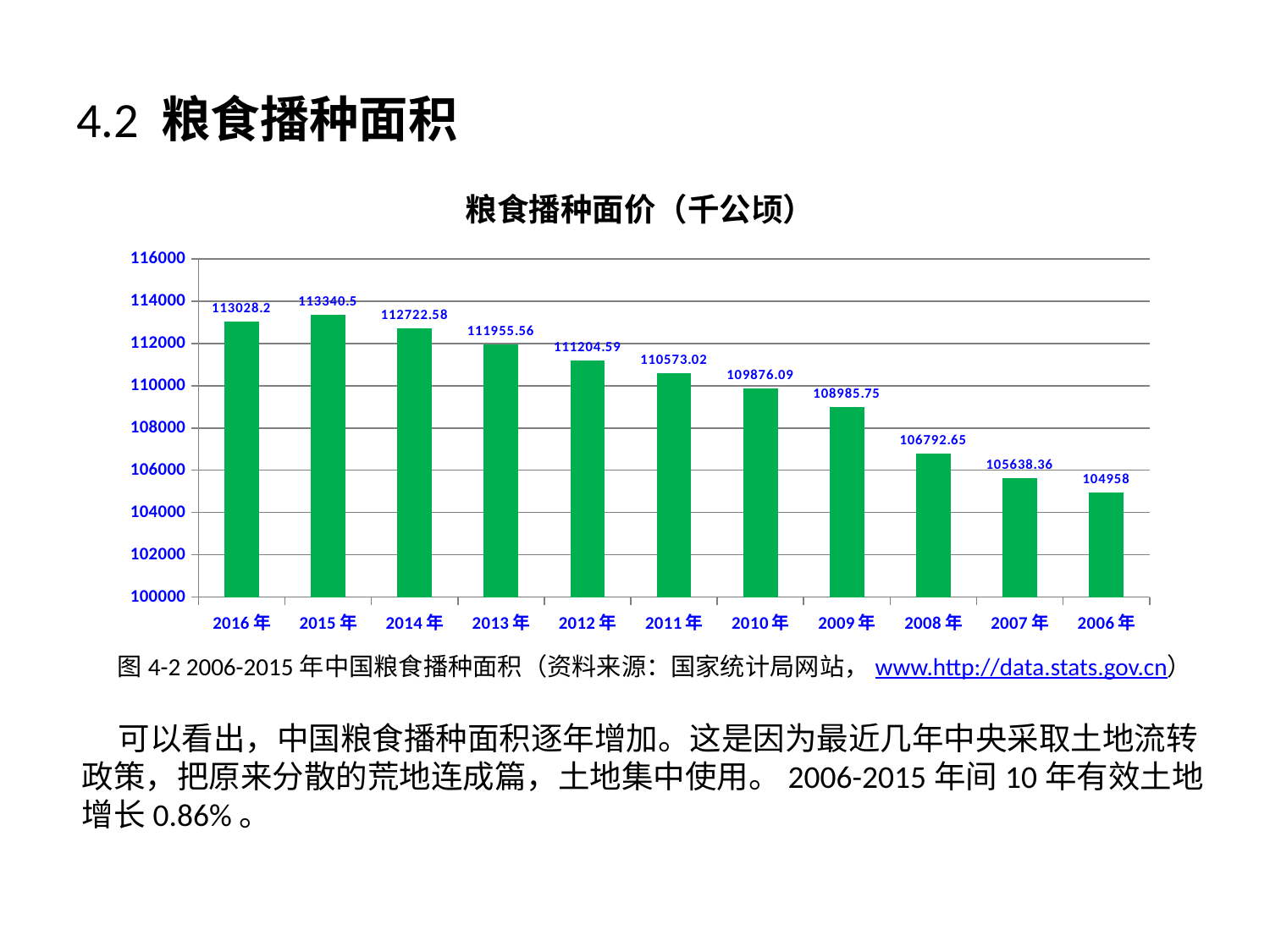
What is the value for 2010年? 109876.09 Which year has the highest value? 2015年 Do the values rise or fall moving from left to right along the x axis? fall What is the difference between the values for 2015年 and 2016年? 312.3 What is the difference between the values for 2016年 and 2006年? 8070.2 Which is larger, the value for 2013年 or the value for 2009年? 2013年 What kind of chart is shown on the slide? bar chart Is the value for 2008年 greater or less than 108000? less Which year has the lowest value? 2006年 What is the value for 2006年? 104958 What is the value for 2016年? 113028.2 How many years are shown on the x axis? 11